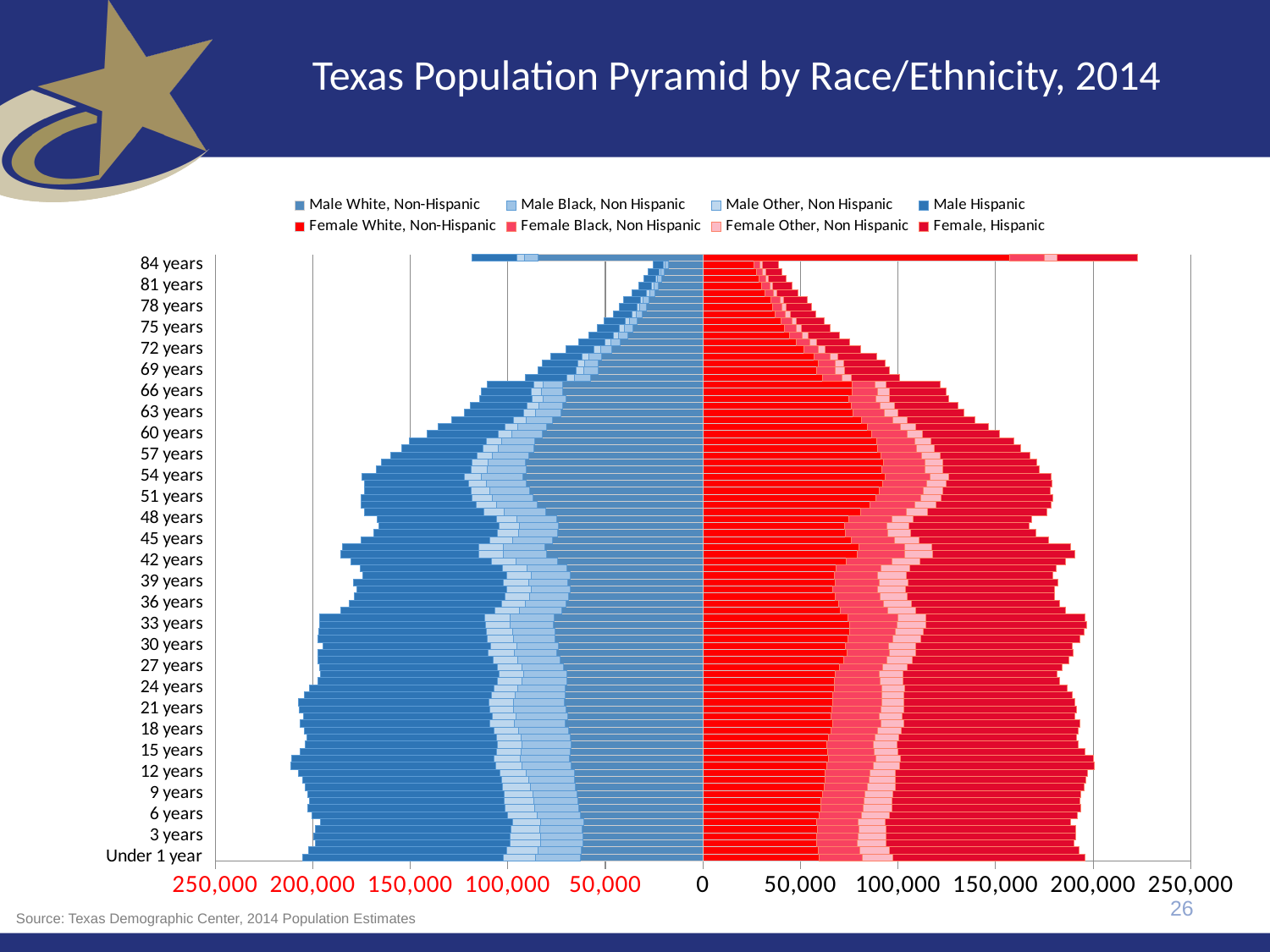
Moving from 45 years up to 81 years, do the male bars generally get longer or shorter? shorter Which colour family is used for the male series and which for the female series? Male series are blue; female series are red How many series does the legend list? 8 What is the title of the chart? Texas Population Pyramid by Race/Ethnicity, 2014 Is the total male bar for 81 years greater or less than 50,000? less Which is larger, the total male bar for 12 years or the total male bar for 81 years? 12 years Is the Male Hispanic segment for Under 1 year greater or less than 50,000? greater What kind of chart is shown on the slide? Bar chart (stacked population pyramid) Is the total male bar for 12 years greater or less than 200,000? greater